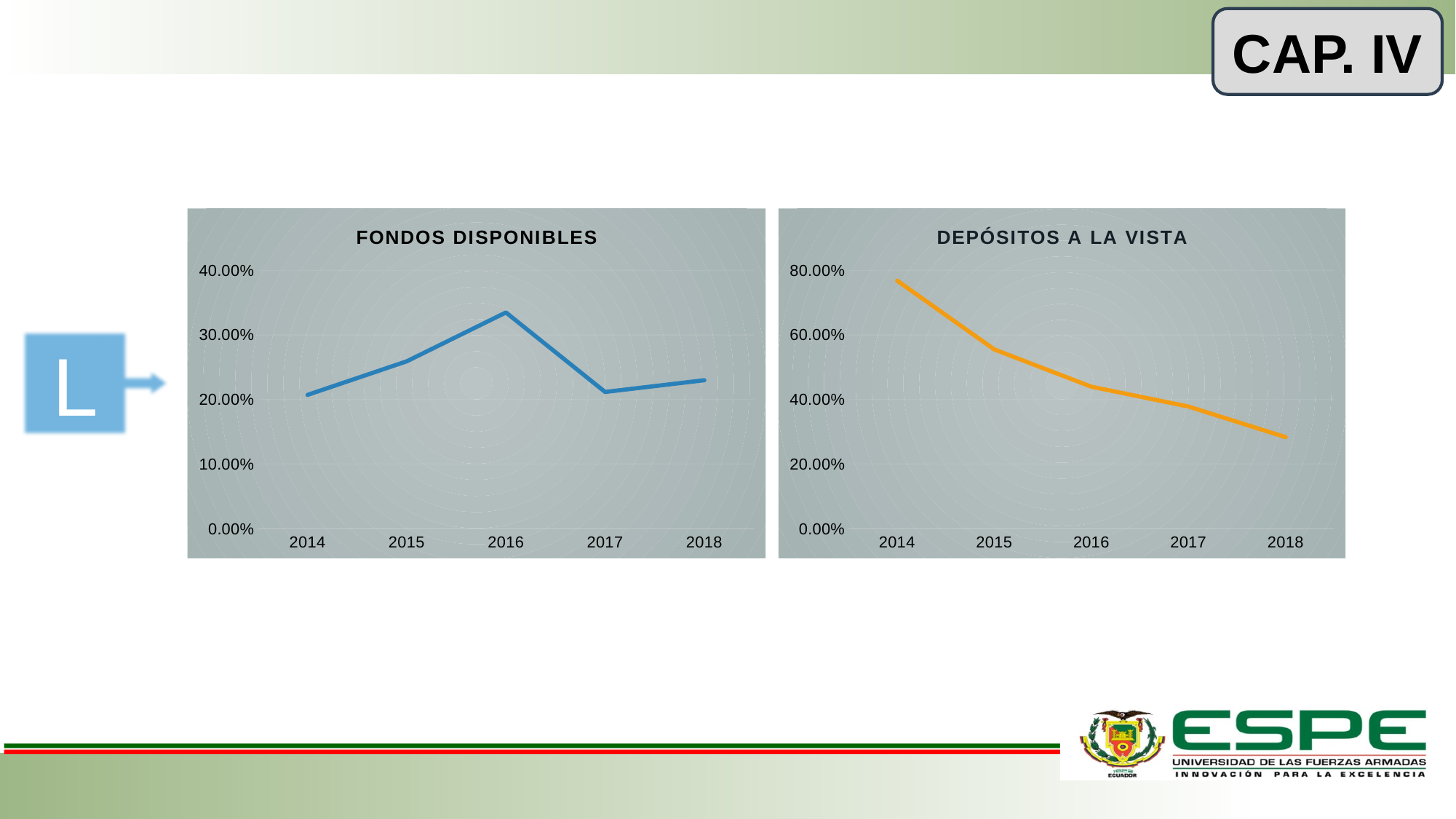
In the FONDOS DISPONIBLES chart, which year has the highest value? 2016 What is the title of the chart on the right side of the slide? DEPÓSITOS A LA VISTA In the DEPÓSITOS A LA VISTA chart, which year has the highest value? 2014 Do the values in the DEPÓSITOS A LA VISTA chart rise or fall from 2014 to 2018? fall In the DEPÓSITOS A LA VISTA chart, which year has the lowest value? 2018 In the FONDOS DISPONIBLES chart, which year has the larger value, 2015 or 2017? 2015 In the DEPÓSITOS A LA VISTA chart, is the value for 2014 greater or less than 60.00%? greater In the FONDOS DISPONIBLES chart, is the value for 2016 greater or less than 30.00%? greater What colour is the line in the DEPÓSITOS A LA VISTA chart? orange How many years are plotted on the DEPÓSITOS A LA VISTA chart? 5 In the DEPÓSITOS A LA VISTA chart, is the value for 2018 greater or less than 40.00%? less What kind of chart is the FONDOS DISPONIBLES chart? line chart